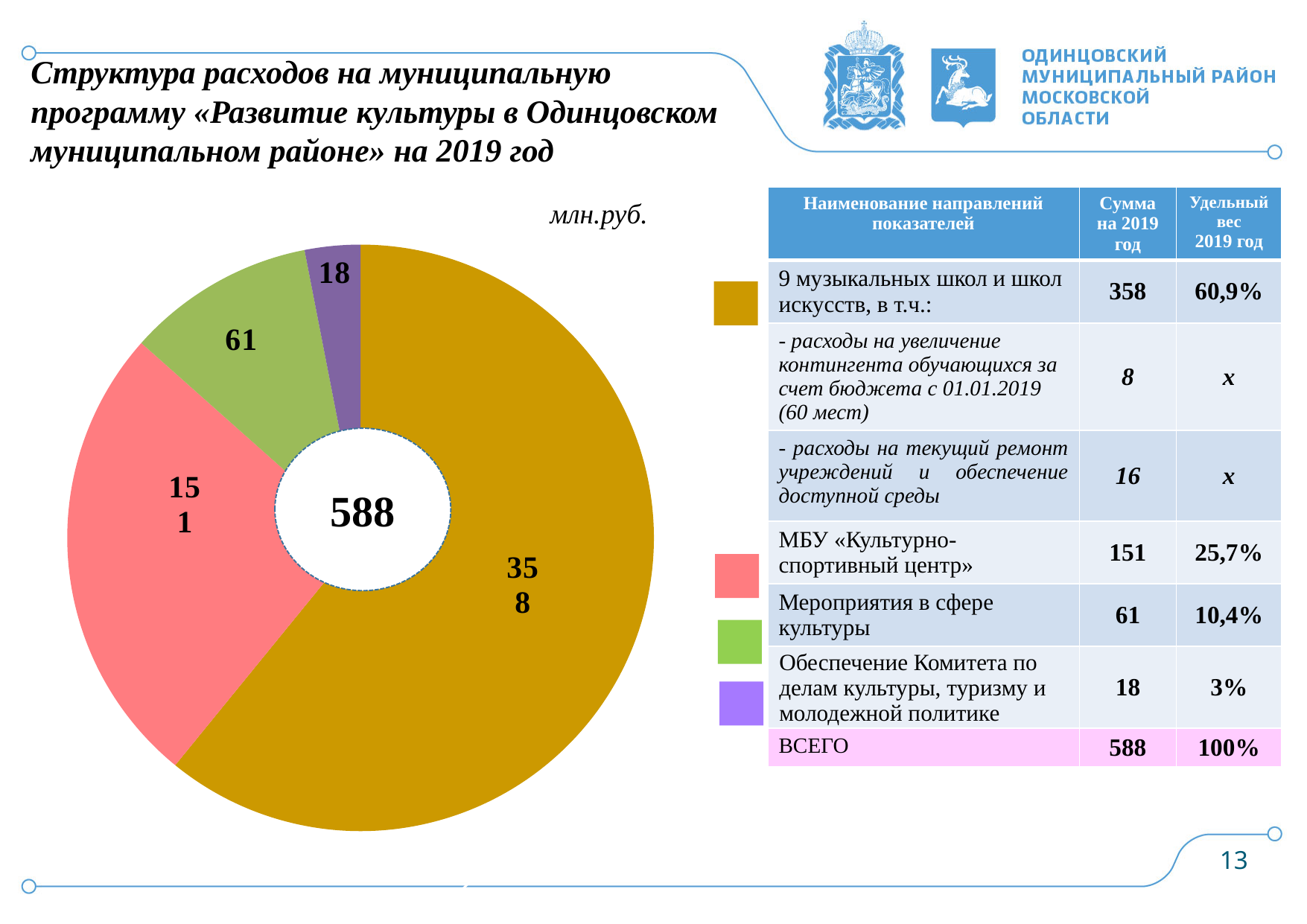
What value is shown for the slice for Обеспечение Комитета по делам культуры, туризму и молодежной политике? 18 What share of the pie does the slice for 9 музыкальных школ и школ искусств represent? 60,9% What value is shown for the slice for Мероприятия в сфере культуры? 61 What is the difference between the slice for 9 музыкальных школ и школ искусств and the slice for МБУ «Культурно-спортивный центр»? 207 How many slices does the pie chart have? 4 Which category has the smallest slice of the pie? Обеспечение Комитета по делам культуры, туризму и молодежной политике Which category has the largest slice of the pie? 9 музыкальных школ и школ искусств Which slice is larger: Мероприятия в сфере культуры or Обеспечение Комитета по делам культуры, туризму и молодежной политике? Мероприятия в сфере культуры What value is shown for the slice for МБУ «Культурно-спортивный центр»? 151 In what units are the values of the pie chart given? млн.руб. What kind of chart is shown on the slide? pie chart What total value is shown in the centre of the pie chart? 588